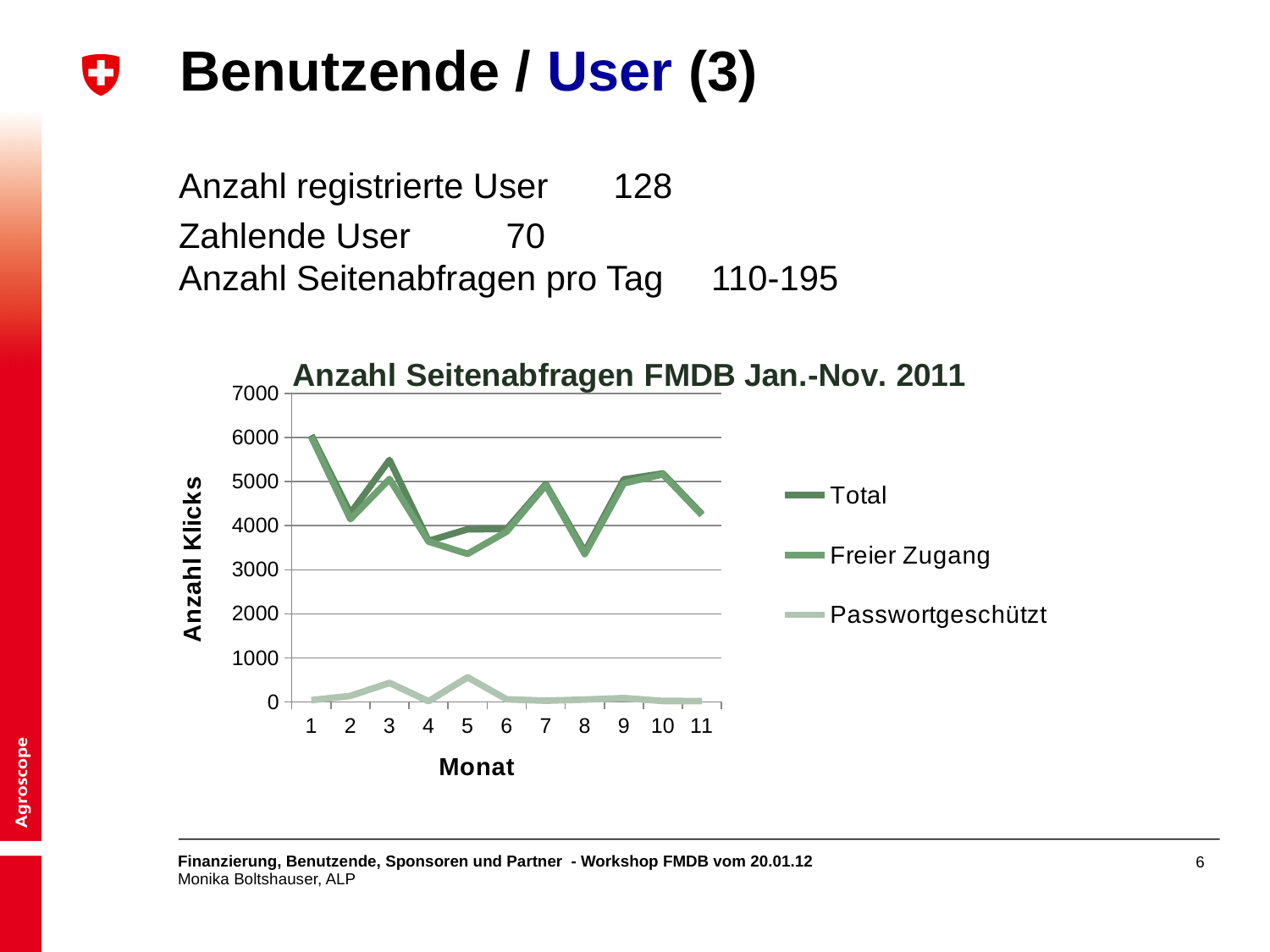
How many months are plotted along the x axis of the chart? 11 Is the Total value for month 8 greater or less than 4000? less How many series does the chart legend list? 3 Is the Passwortgeschützt value for month 1 greater or less than 1000? less Is the Total value for month 1 greater or less than 5000? greater In which month is the Passwortgeschützt series at its highest? 5 What kind of chart is shown on the slide? Line chart Which is larger for the Total series: the value for month 1 or the value for month 11? Month 1 In which month is the Total series at its highest? 1 Does the Total series rise or fall from month 1 to month 4? Fall What is the label of the chart's y axis? Anzahl Klicks